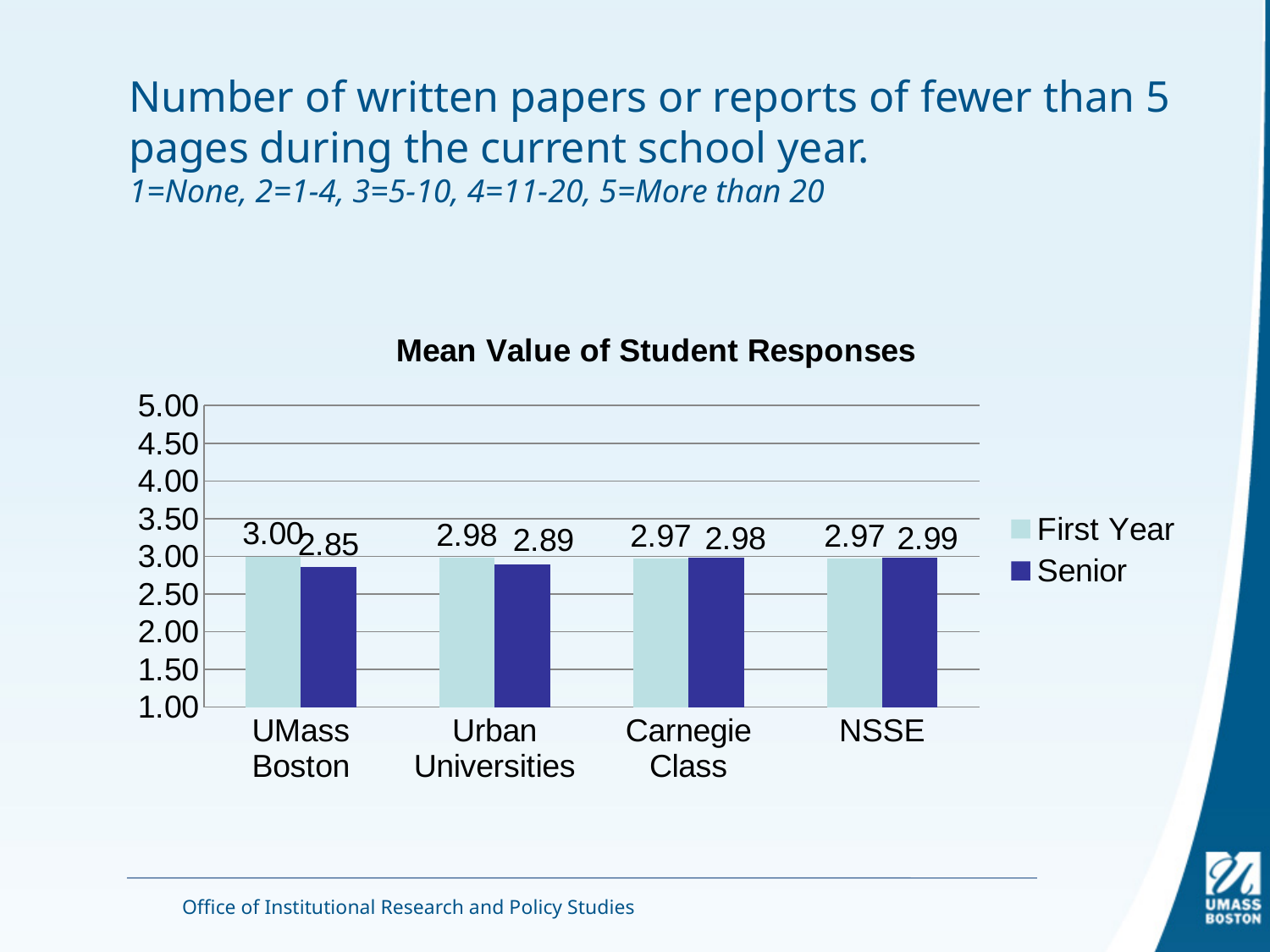
What type of chart is shown on the slide? bar chart Which category has the highest First Year mean value? UMass Boston Which category has the lowest Senior mean value? UMass Boston What is the Senior mean value for Urban Universities? 2.89 What is the First Year mean value for Carnegie Class? 2.97 For Carnegie Class, which is larger: the First Year or the Senior mean value? Senior Is the Senior mean value for UMass Boston greater or less than 3.00? less How many categories are shown on the x axis? 4 What is the First Year mean value for UMass Boston? 3.00 What is the difference between the First Year and Senior mean values for UMass Boston? 0.15 What is the Senior mean value for NSSE? 2.99 How many series does the legend list? 2